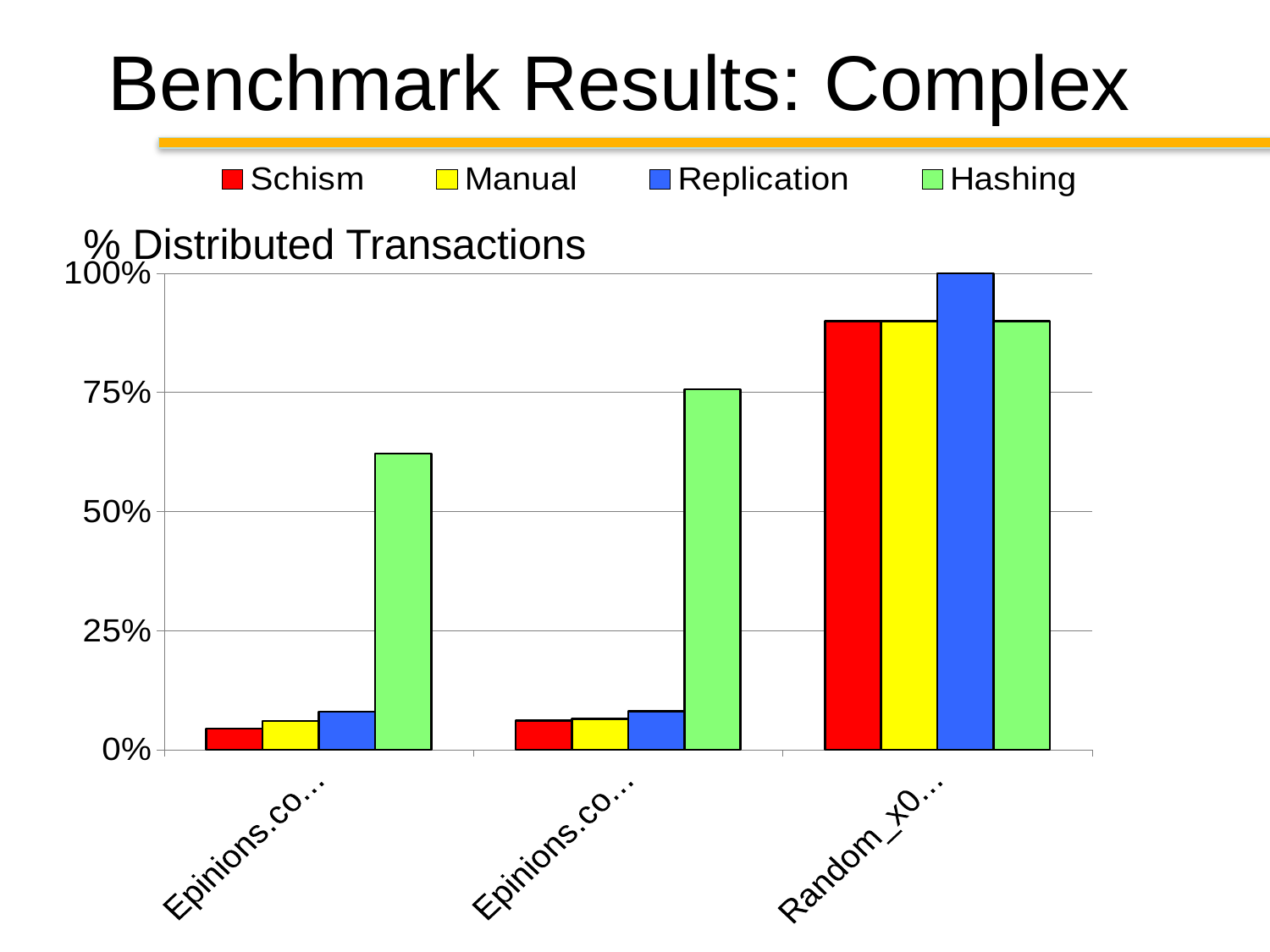
In the leftmost group, which series has the highest value? Hashing In the rightmost (Random_x0…) group, which series has the highest value? Replication What is the value for Replication in the rightmost (Random_x0…) group? 100% What kind of chart is shown on the slide? bar chart Is the value for Replication in the middle group greater or less than 25%? less How many series does the legend list? 4 What is the label shown on the vertical axis of the chart? % Distributed Transactions Do the Hashing values rise or fall moving from the leftmost group to the rightmost group? rise How many category groups are plotted along the x axis? 3 Is the value for Schism in the leftmost group greater or less than 25%? less In the middle group, which is larger: the value for Hashing or the value for Schism? Hashing Is the value for Hashing in the leftmost group greater or less than 50%? greater